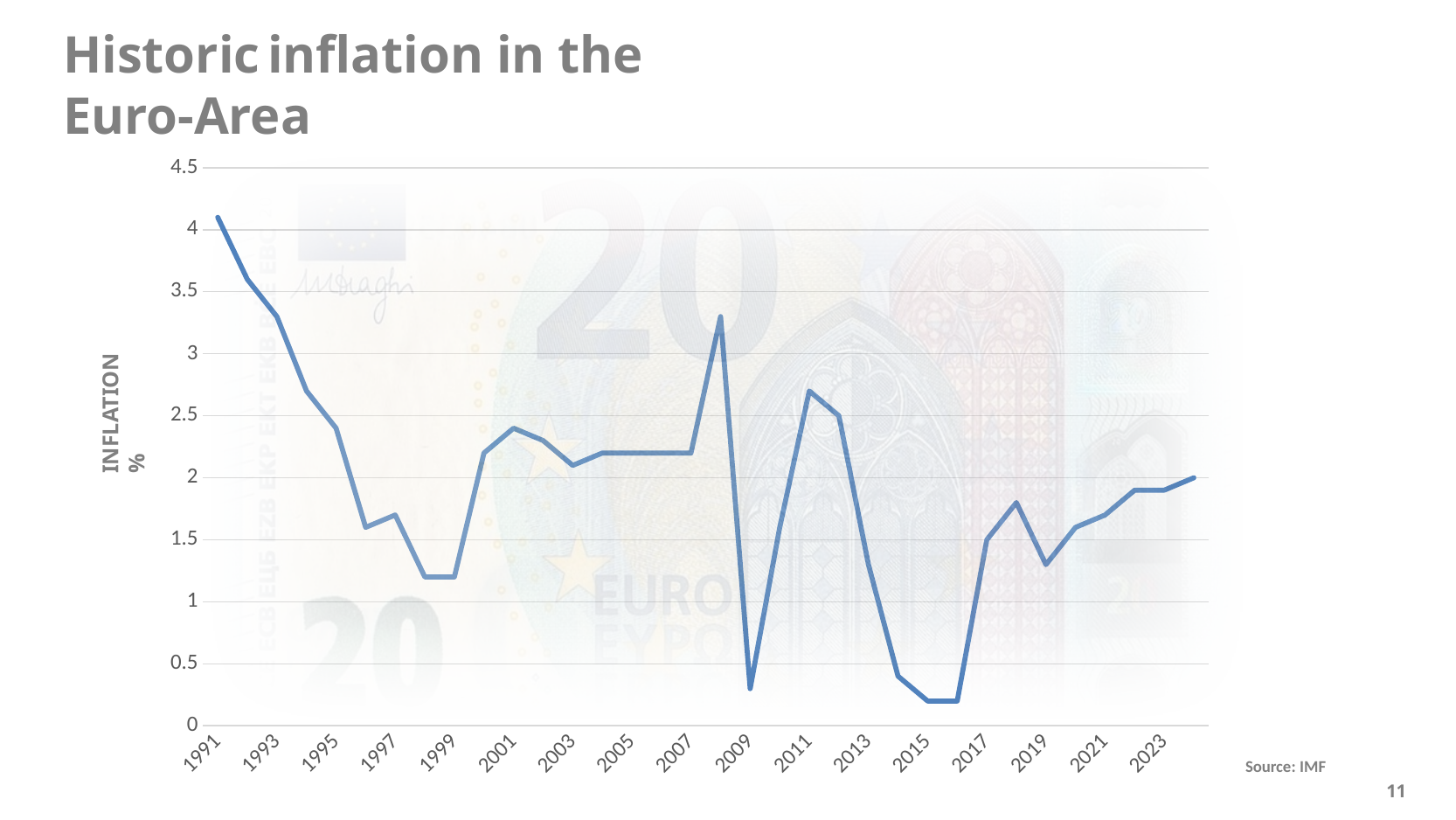
What kind of chart is shown on the slide? line chart Does inflation rise or fall between 1991 and 1999? fall Is the inflation value for 2008 greater or less than 3? greater Which year has higher inflation, 1991 or 2008? 1991 Which year has higher inflation, 2009 or 2011? 2011 Is the inflation value for 2009 greater or less than 0.5? less Is the inflation value for 1991 greater or less than 3.5? greater What is the source cited for the chart? IMF In which year is inflation highest? 1991